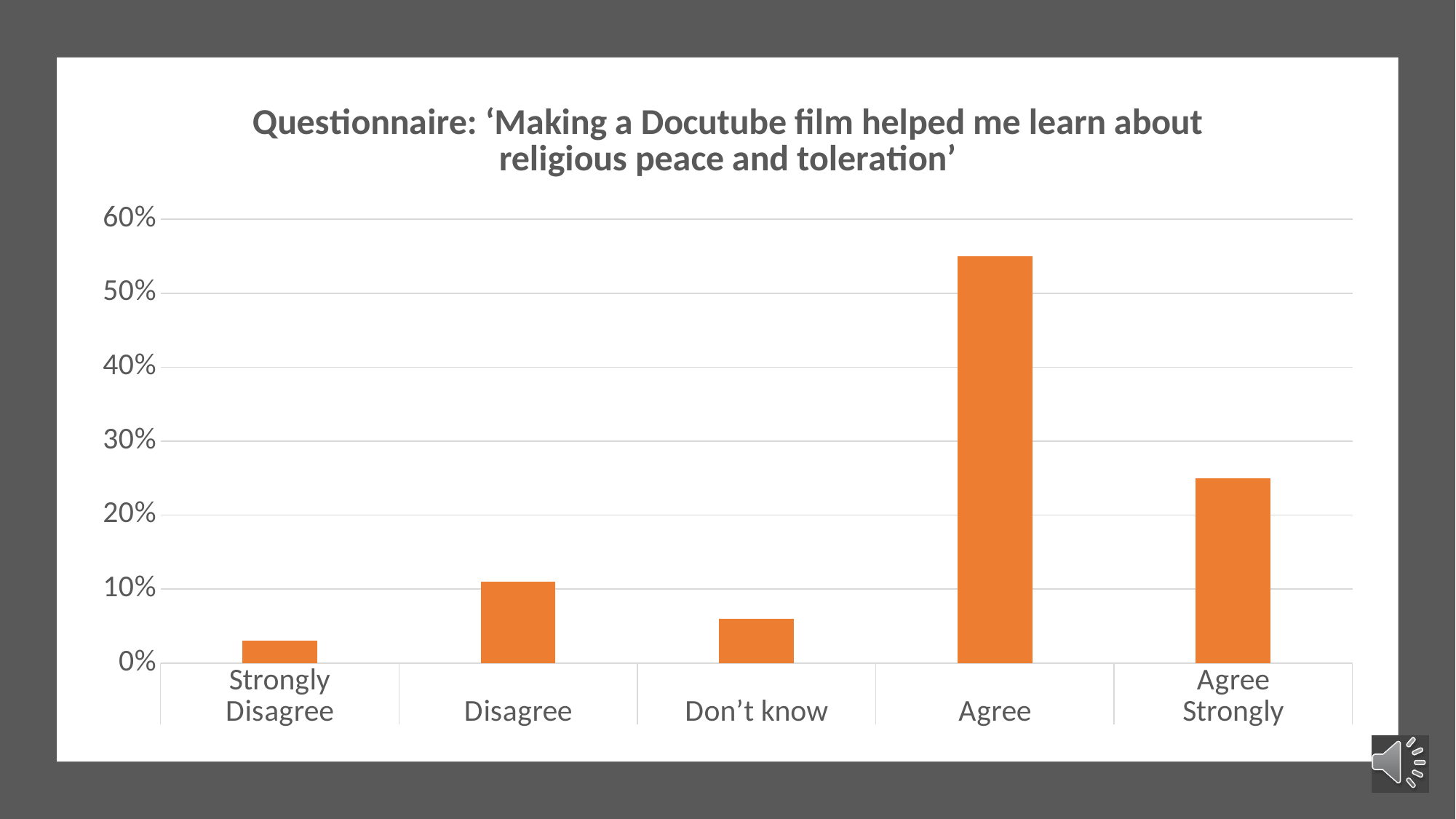
Which is larger, the value for Disagree or the value for Don't know? Disagree Is the value for Agree greater or less than 50%? greater How many response categories are shown on the x axis? 5 Which response category has the highest value? Agree Is the value for Strongly Disagree greater or less than 10%? less What is the title of the chart? Questionnaire: 'Making a Docutube film helped me learn about religious peace and toleration' What kind of chart is shown on the slide? Bar chart Is the value for Agree Strongly greater or less than 30%? less Which is larger, the value for Agree or the value for Agree Strongly? Agree Which response category has the lowest value? Strongly Disagree